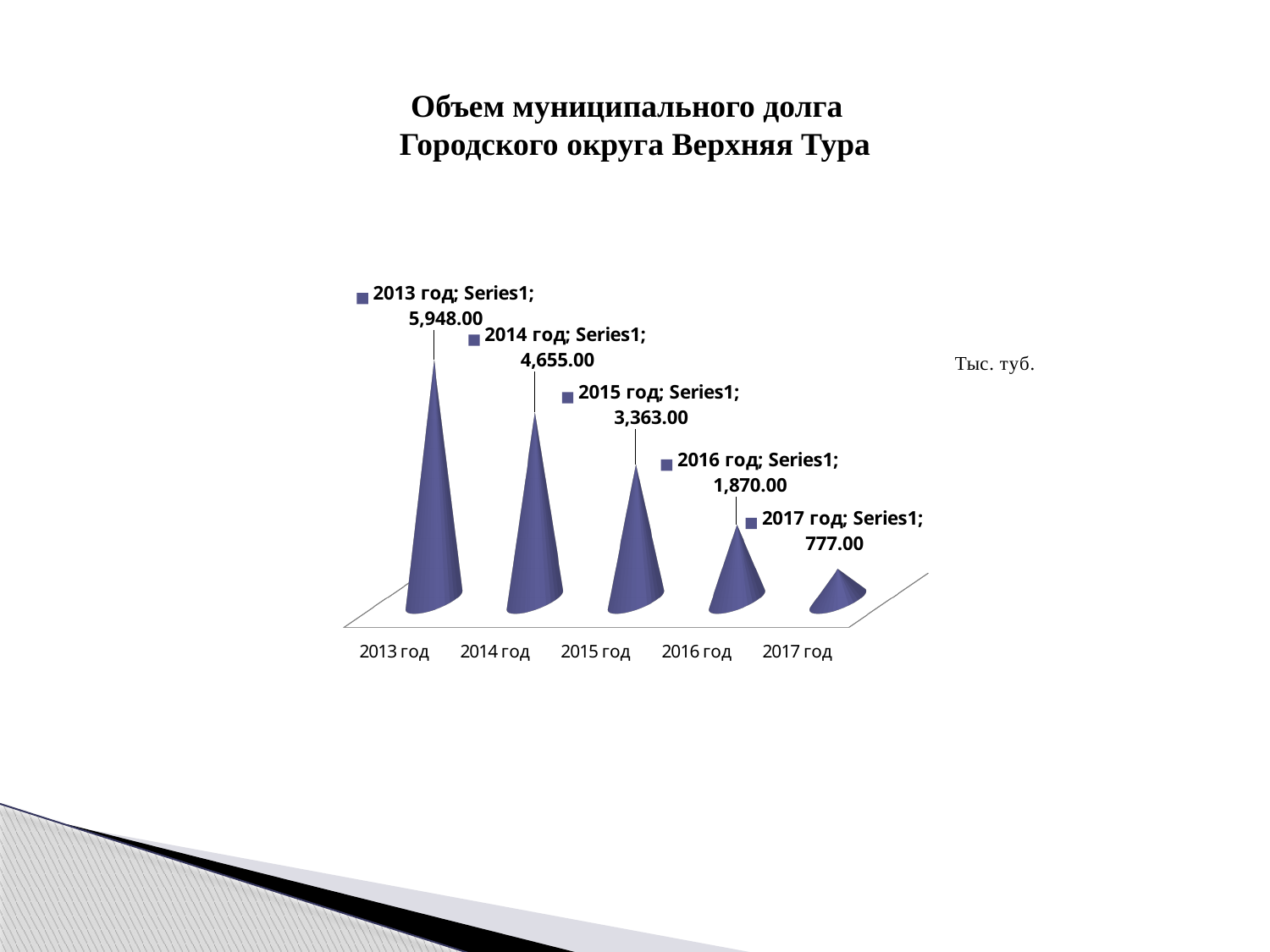
Which is larger, the value for 2014 год or the value for 2016 год? 2014 год How many years are shown on the chart? 5 What is the difference between the values for 2013 год and 2014 год? 1,293.00 What is the value for 2013 год? 5,948.00 Which year has the lowest value? 2017 год What is the title of the chart? Объем муниципального долга Городского округа Верхняя Тура What is the value for 2017 год? 777.00 Which year has the highest value? 2013 год What kind of chart is this? bar chart What is the value for 2015 год? 3,363.00 Do the values rise or fall from 2013 год to 2017 год? fall What is the difference between the values for 2016 год and 2017 год? 1,093.00